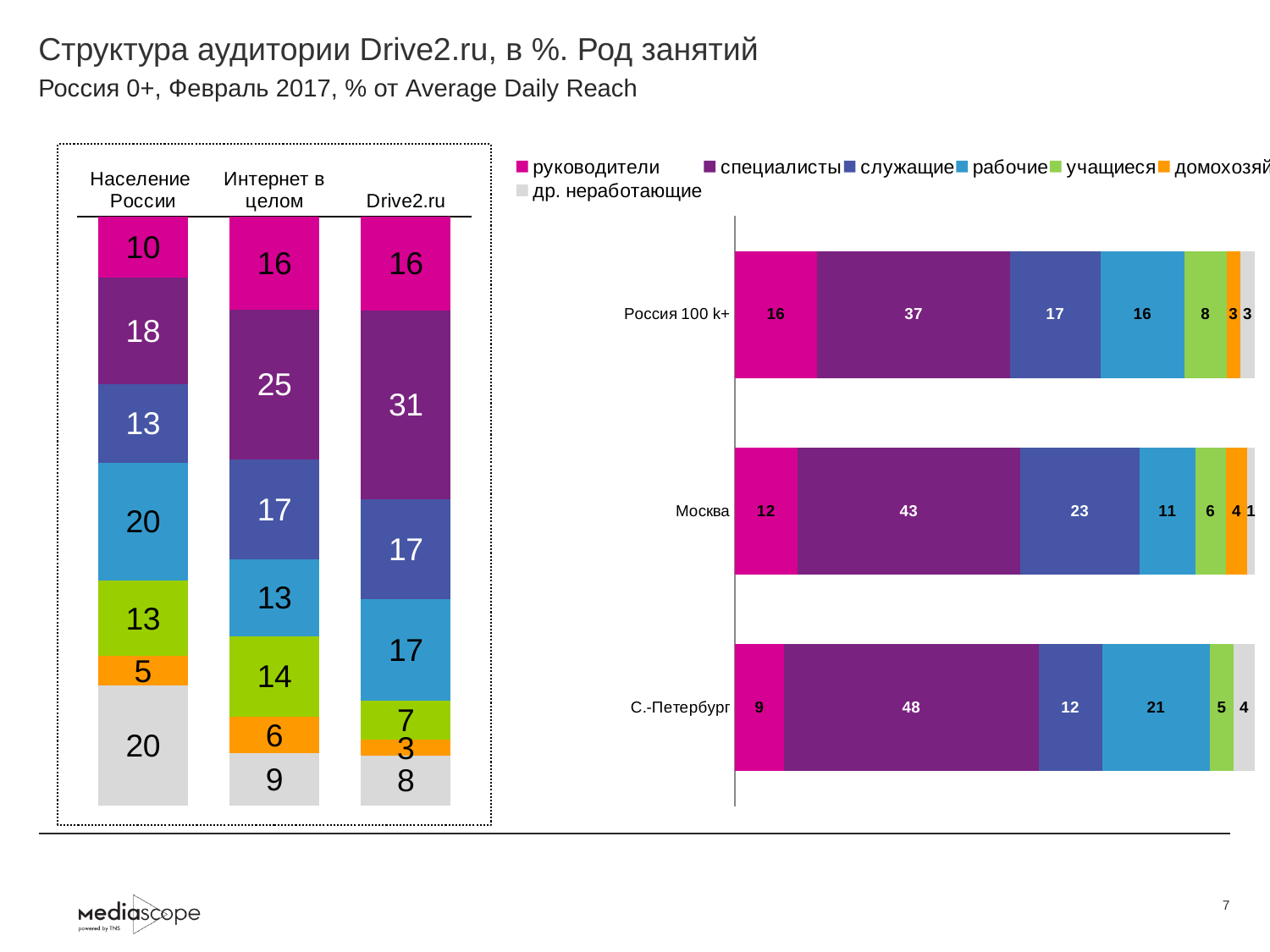
How many series does the legend list? 7 In the left chart, which is larger: рабочие for Население России or рабочие for Drive2.ru? Население России What type of chart is the right chart? Stacked bar chart In the right chart, which category has the highest value for специалисты? С.-Петербург In the left chart, which column has the lowest value for руководители? Население России In the left chart, what is the value for др. неработающие for Население России? 20 In the right chart, what is the value for специалисты for Москва? 43 How many categories are shown on the right chart? 3 In the right chart, what is the value for рабочие for С.-Петербург? 21 In the left chart, what is the value for специалисты in the Drive2.ru column? 31 In the right chart, what is the difference between the служащие values for Москва and С.-Петербург? 11 In the left chart, what is the difference between the руководители values for Drive2.ru and Население России? 6